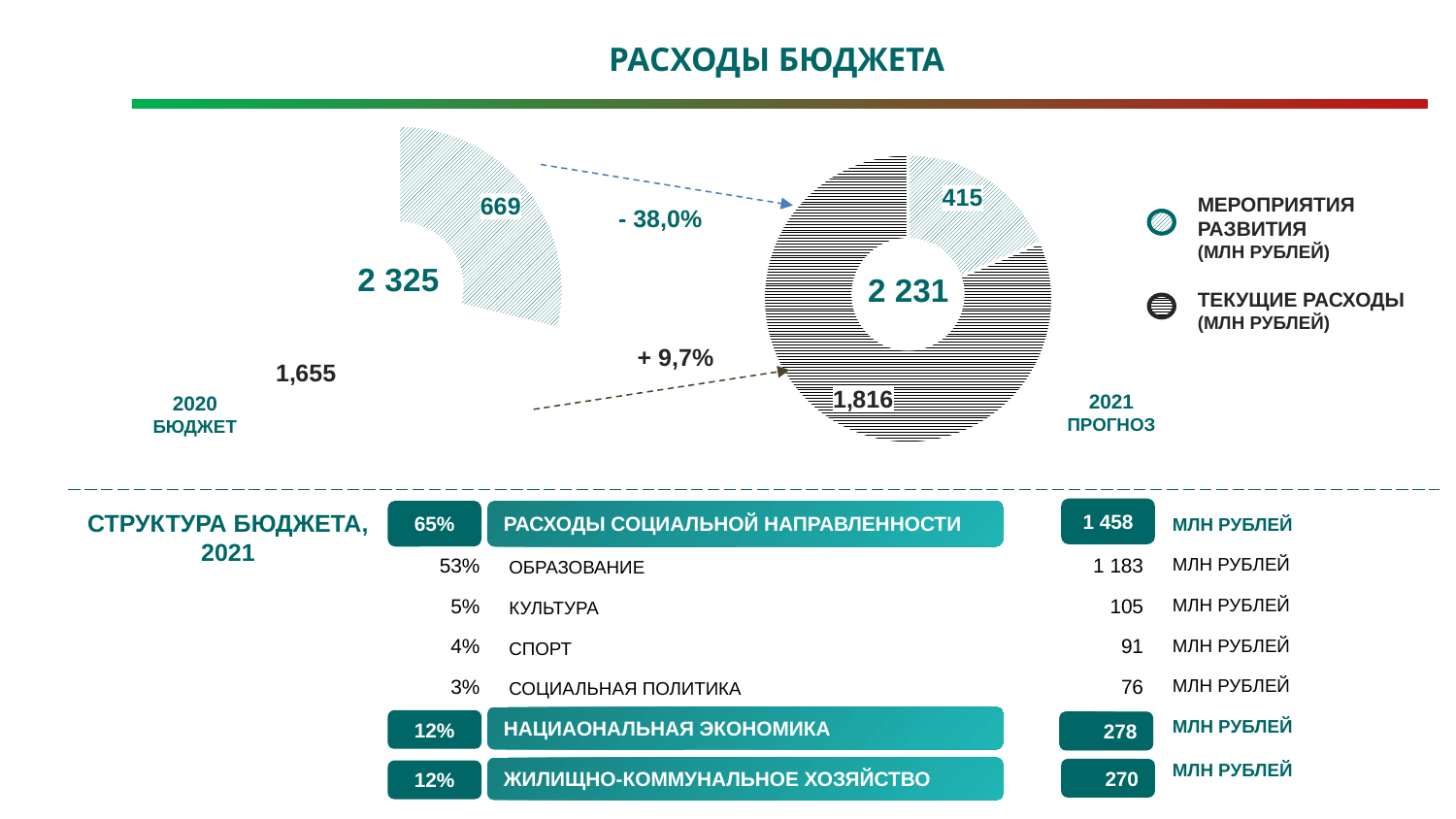
In the 2020 budget chart, what is the value for development activities (мероприятия развития)? 669 In the 2021 forecast chart, what is the value for current expenses (текущие расходы)? 1,816 In the 2021 forecast chart, which segment is larger: development activities or current expenses? Current expenses (текущие расходы) What total is shown in the centre of the 2020 budget chart? 2 325 By how much do current expenses exceed development activities in the 2021 forecast chart? 1401 How many series does the legend list for the donut charts? 2 What type of chart is used to show the 2020 budget and 2021 forecast expenses? Doughnut (pie) chart What percentage change in development activities is shown between the 2020 and 2021 charts? - 38,0% In the 2021 forecast chart, what is the value for development activities (мероприятия развития)? 415 By how much did development activities decrease from the 2020 budget chart (669) to the 2021 forecast chart (415)? 254 What total is shown in the centre of the 2021 forecast chart? 2 231 In the 2020 budget chart, what is the value for current expenses (текущие расходы)? 1,655